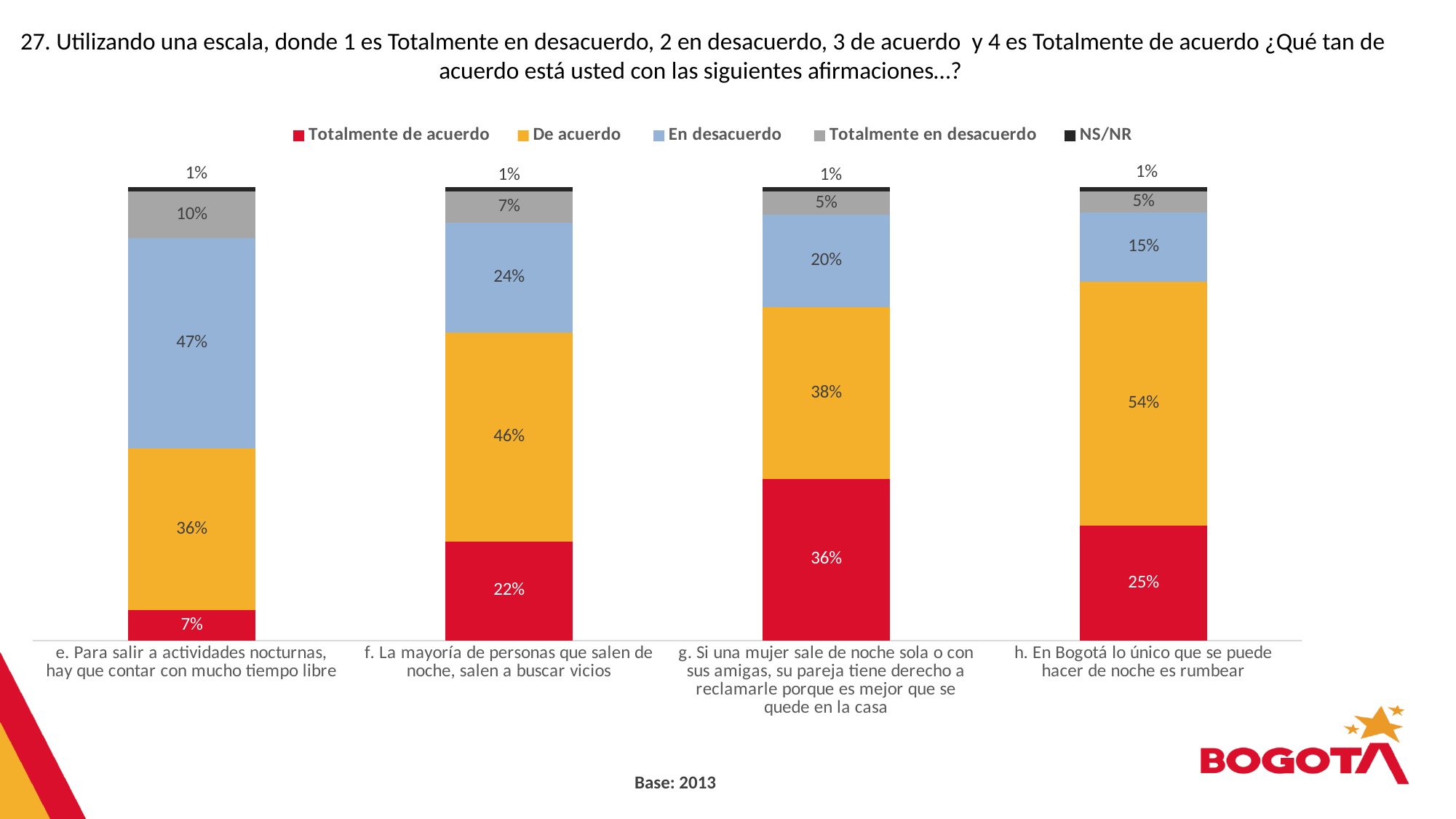
What kind of chart is shown on the slide? Stacked bar chart How many statements (categories) are plotted on the x axis? 4 What is the 'En desacuerdo' value for statement e (Para salir a actividades nocturnas, hay que contar con mucho tiempo libre)? 47% What is the 'De acuerdo' value for statement h (En Bogotá lo único que se puede hacer de noche es rumbear)? 54% What is the total of the stacked bar for statement g, summing all five labelled segments? 100% Which series is shown in red in the legend? Totalmente de acuerdo What is the difference between the 'De acuerdo' values for statement h and statement g? 16% Which statement has the lowest 'Totalmente de acuerdo' value? e. Para salir a actividades nocturnas, hay que contar con mucho tiempo libre How many series does the legend list? 5 Which statement has the highest 'Totalmente de acuerdo' value? g. Si una mujer sale de noche sola o con sus amigas, su pareja tiene derecho a reclamarle porque es mejor que se quede en la casa Which is larger: the 'En desacuerdo' value for statement f or for statement h? Statement f (24%) What is the 'Totalmente de acuerdo' value for statement f (La mayoría de personas que salen de noche, salen a buscar vicios)? 22%